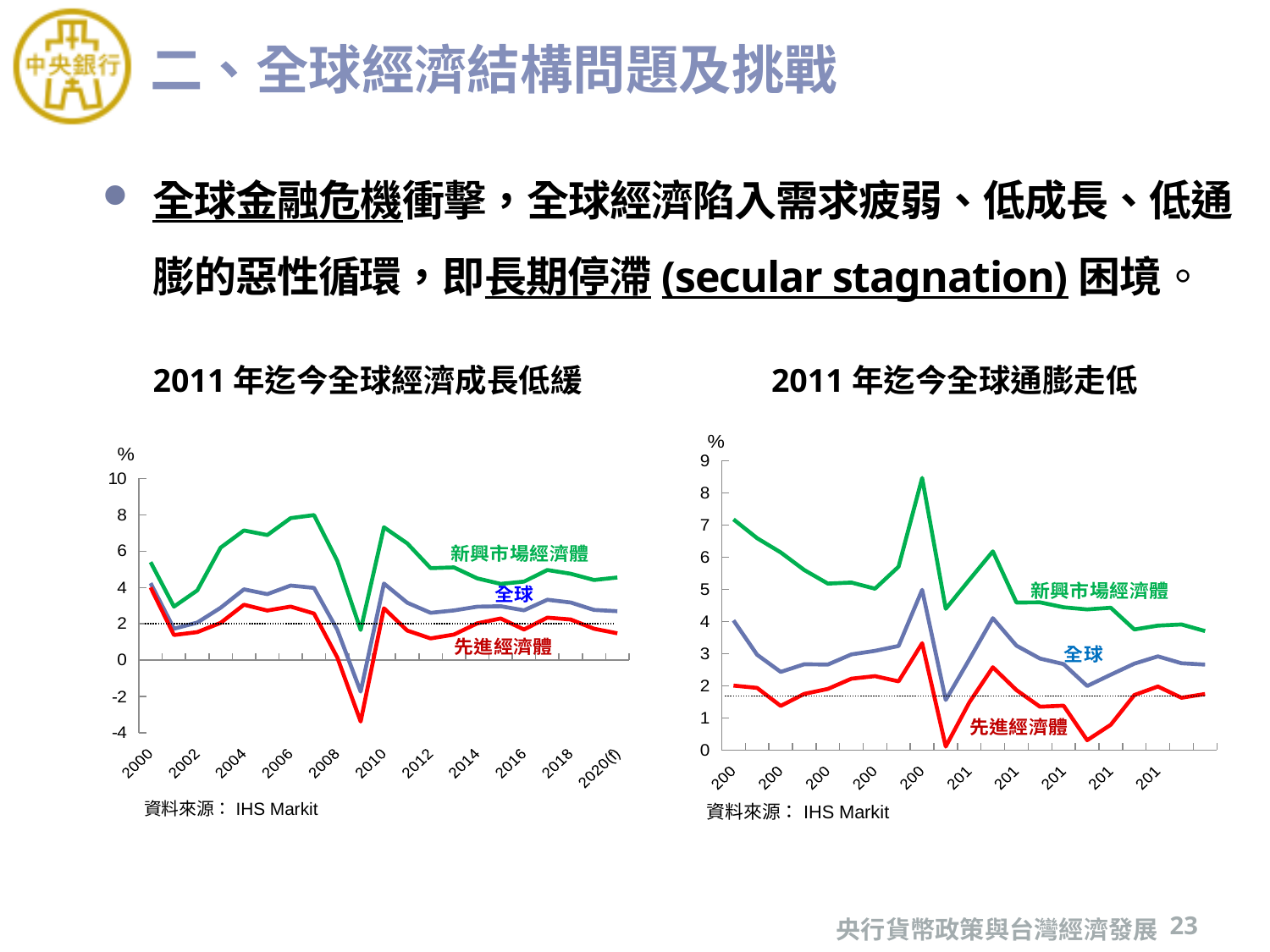
What kind of chart is the left chart titled 2011 年迄今全球經濟成長低緩? line chart On the right chart (2011 年迄今全球通膨走低), does the 全球 line generally rise or fall from its 2011 peak to the end of the period? fall On the left chart (2011 年迄今全球經濟成長低緩), is the value for 全球 in 2009 greater or less than 0? less On the right chart (2011 年迄今全球通膨走低), is the peak value of 新興市場經濟體 greater or less than 8? greater On the left chart (2011 年迄今全球經濟成長低緩), which is higher in 2010, 新興市場經濟體 or 先進經濟體? 新興市場經濟體 On the right chart (2011 年迄今全球通膨走低), which series has the lowest values across the period? 先進經濟體 On the left chart (2011 年迄今全球經濟成長低緩), is the value for 新興市場經濟體 in 2007 greater or less than 6? greater What data source is cited below both charts? IHS Markit How many series are labelled on the left chart (2011 年迄今全球經濟成長低緩)? 3 On the right chart (2011 年迄今全球通膨走低), which series has the highest values across the period? 新興市場經濟體 What kind of chart is the right chart titled 2011 年迄今全球通膨走低? line chart